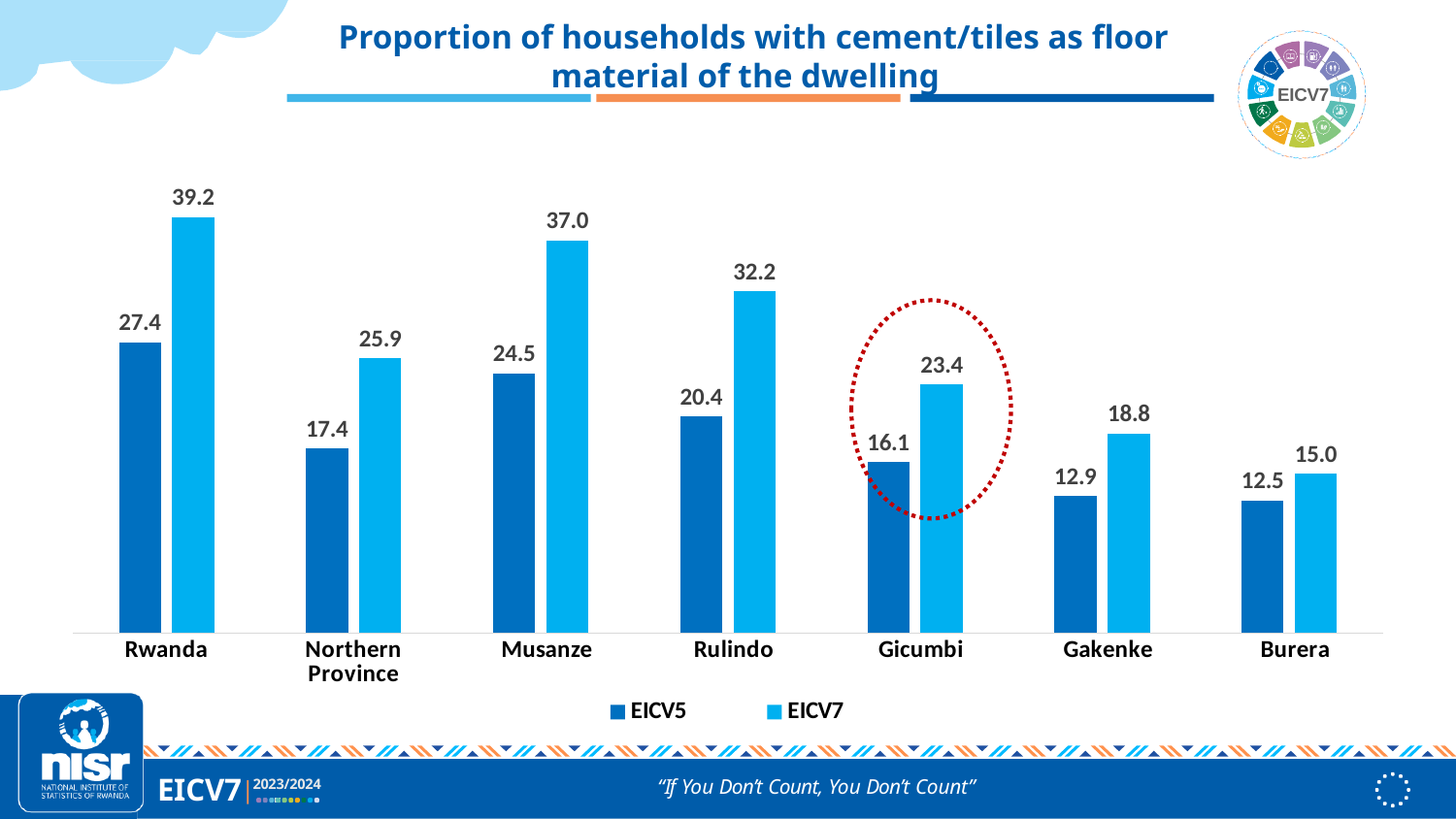
How many series does the legend list? 2 Which category has the lowest EICV5 value? Burera Which is larger, the EICV7 value for Rulindo or the EICV7 value for Gakenke? EICV7 value for Rulindo What is the EICV7 value for Northern Province? 25.9 What kind of chart is shown on the slide? Bar chart Which category has the highest EICV7 value? Rwanda What is the difference between the EICV7 and EICV5 values for Gicumbi? 7.3 What is the EICV7 value for Rwanda? 39.2 What is the EICV5 value for Gicumbi? 16.1 What is the difference between the EICV7 and EICV5 values for Musanze? 12.5 How many categories are shown on the x axis? 7 Which category is highlighted with a red dotted circle? Gicumbi